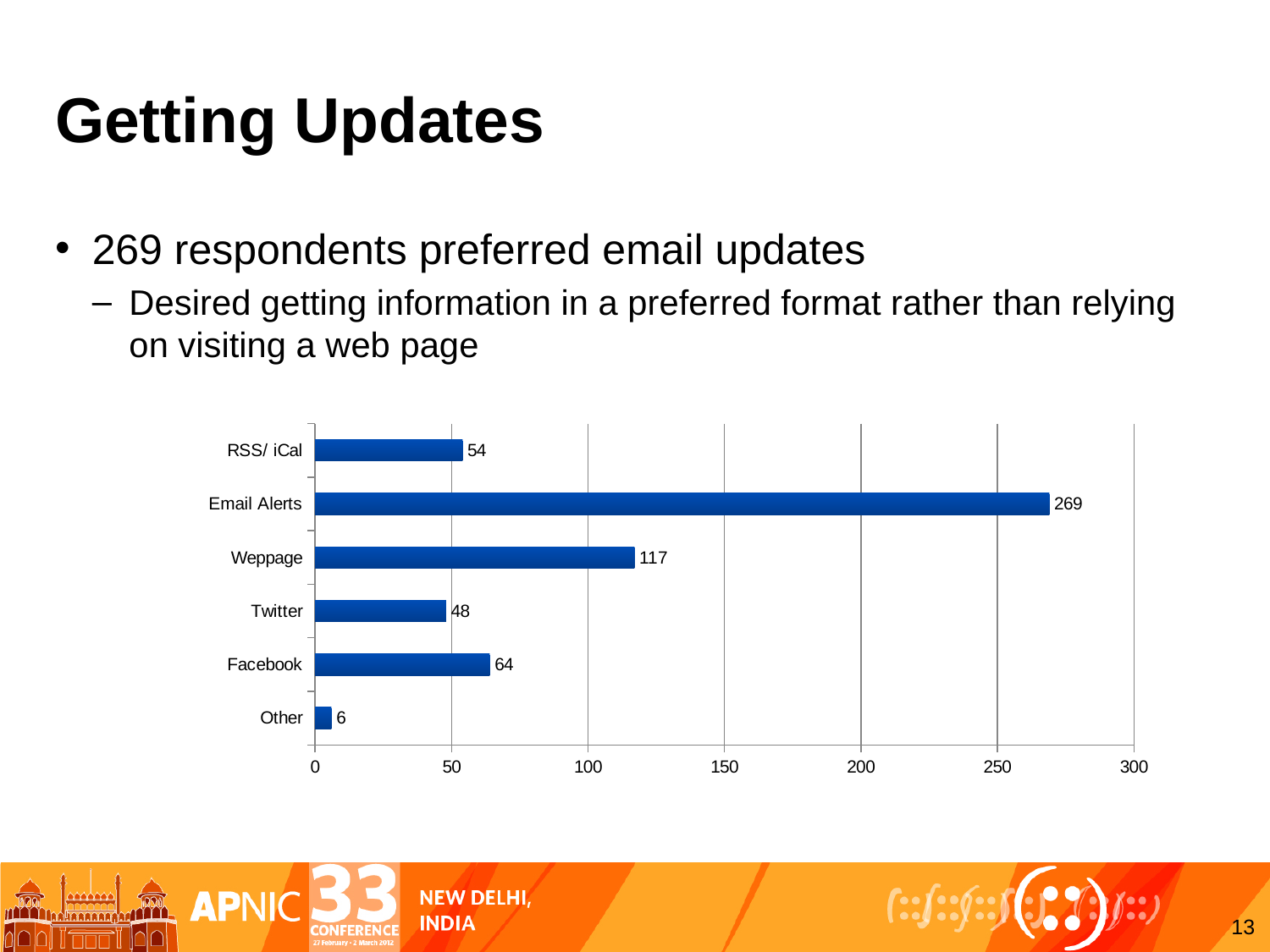
What is the value for Email Alerts? 269 How many categories are shown in the chart? 6 Which is larger, the value for RSS/ iCal or the value for Facebook? Facebook What kind of chart is shown on the slide? bar chart What is the value for Weppage? 117 Which category has the highest value? Email Alerts What is the difference between the values for Facebook and Twitter? 16 What is the difference between the values for Email Alerts and Weppage? 152 What is the value for Facebook? 64 Is the value for Weppage greater or less than 100? greater Which category has the lowest value? Other What is the value for Twitter? 48